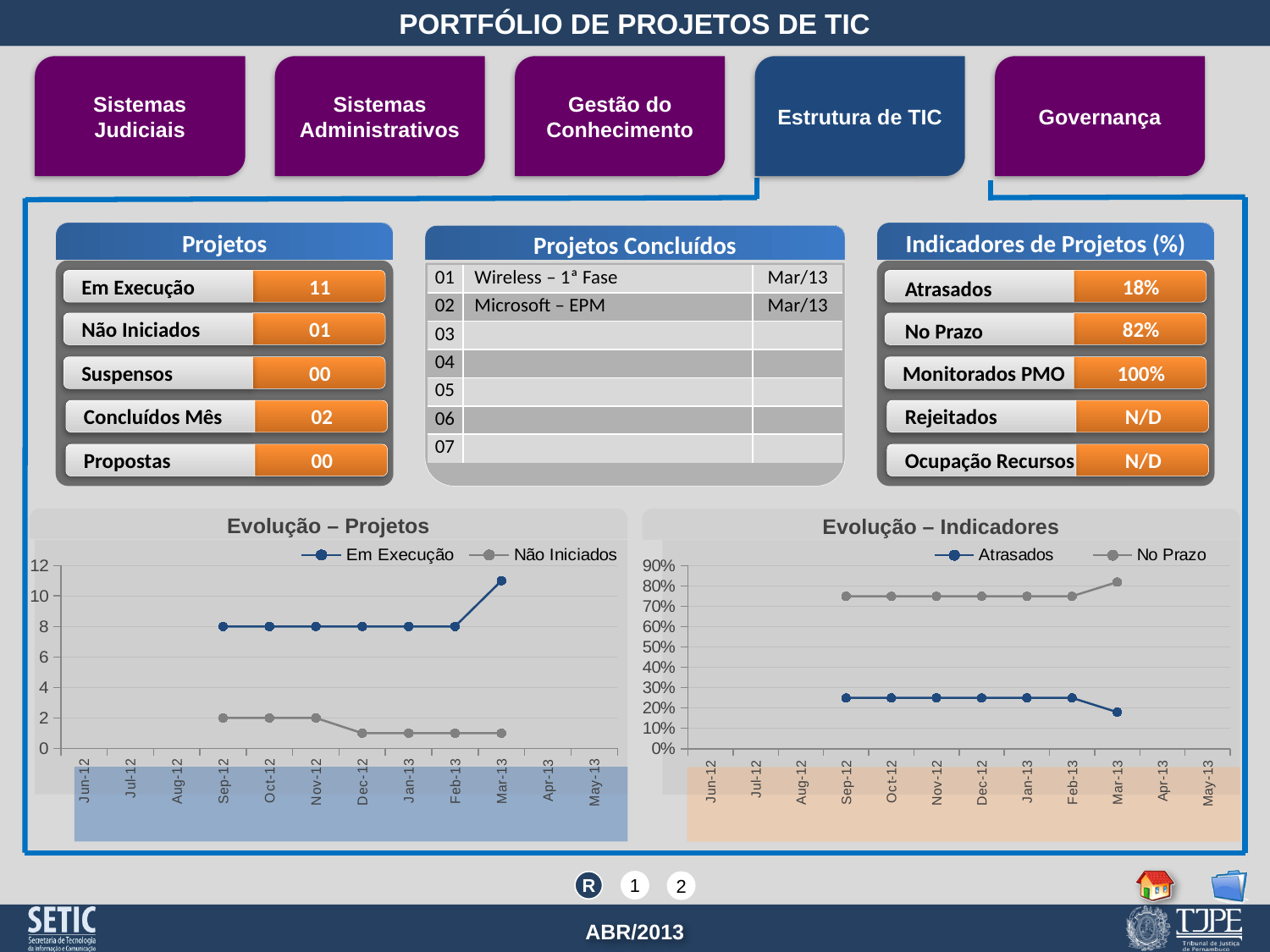
On the 'Evolução – Indicadores' chart, how many series does the legend list? 2 On the 'Evolução – Projetos' chart, which series is higher at Sep-12, Em Execução or Não Iniciados? Em Execução On the 'Evolução – Indicadores' chart, which series is higher at Jan-13, Atrasados or No Prazo? No Prazo On the 'Evolução – Projetos' chart, what kind of chart is it? line chart On the 'Evolução – Indicadores' chart, is the value for No Prazo at Mar-13 greater or less than 80%? greater On the 'Evolução – Indicadores' chart, is the value for Atrasados at Mar-13 greater or less than 20%? less On the 'Evolução – Projetos' chart, is the value for Não Iniciados at Dec-12 greater or less than 2? less On the 'Evolução – Projetos' chart, how many series does the legend list? 2 On the 'Evolução – Projetos' chart, does the Em Execução series rise or fall from Feb-13 to Mar-13? rise On the 'Evolução – Projetos' chart, what is the value of Em Execução at Sep-12? 8 On the 'Evolução – Projetos' chart, what is the value of Não Iniciados at Sep-12? 2